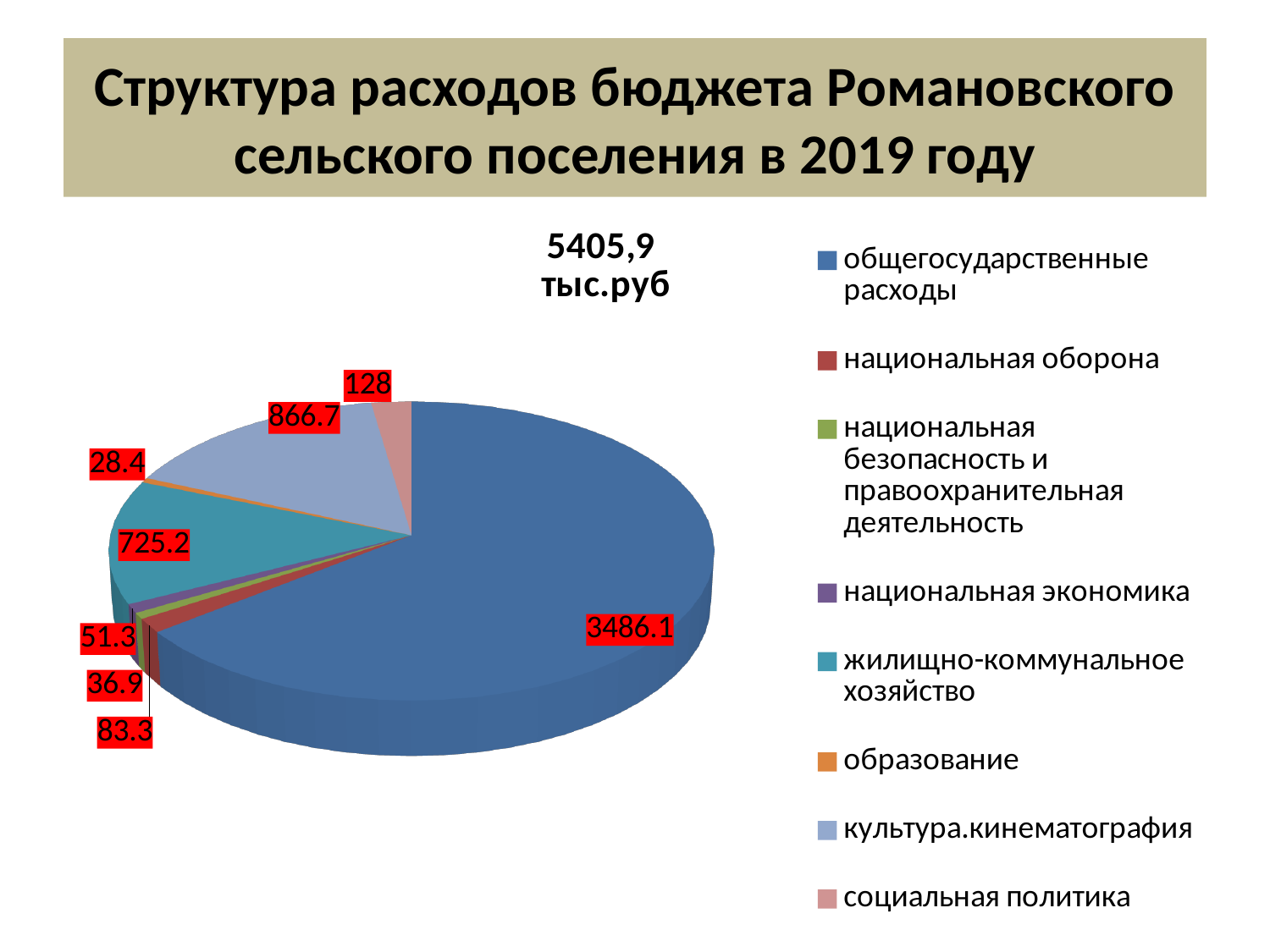
Which is larger: жилищно-коммунальное хозяйство or культура.кинематография? культура.кинематография What is the value for жилищно-коммунальное хозяйство? 725.2 What is the value for социальная политика? 128 Which category has the smallest slice of the pie? образование What is the value for общегосударственные расходы? 3486.1 What is the value for культура.кинематография? 866.7 What is the title shown above the pie chart? 5405,9 тыс.руб What is the difference between the values for культура.кинематография and жилищно-коммунальное хозяйство? 141.5 Which category has the largest slice of the pie? общегосударственные расходы What is the value for образование? 28.4 How many categories does the legend list? 8 What kind of chart is shown on the slide? pie chart